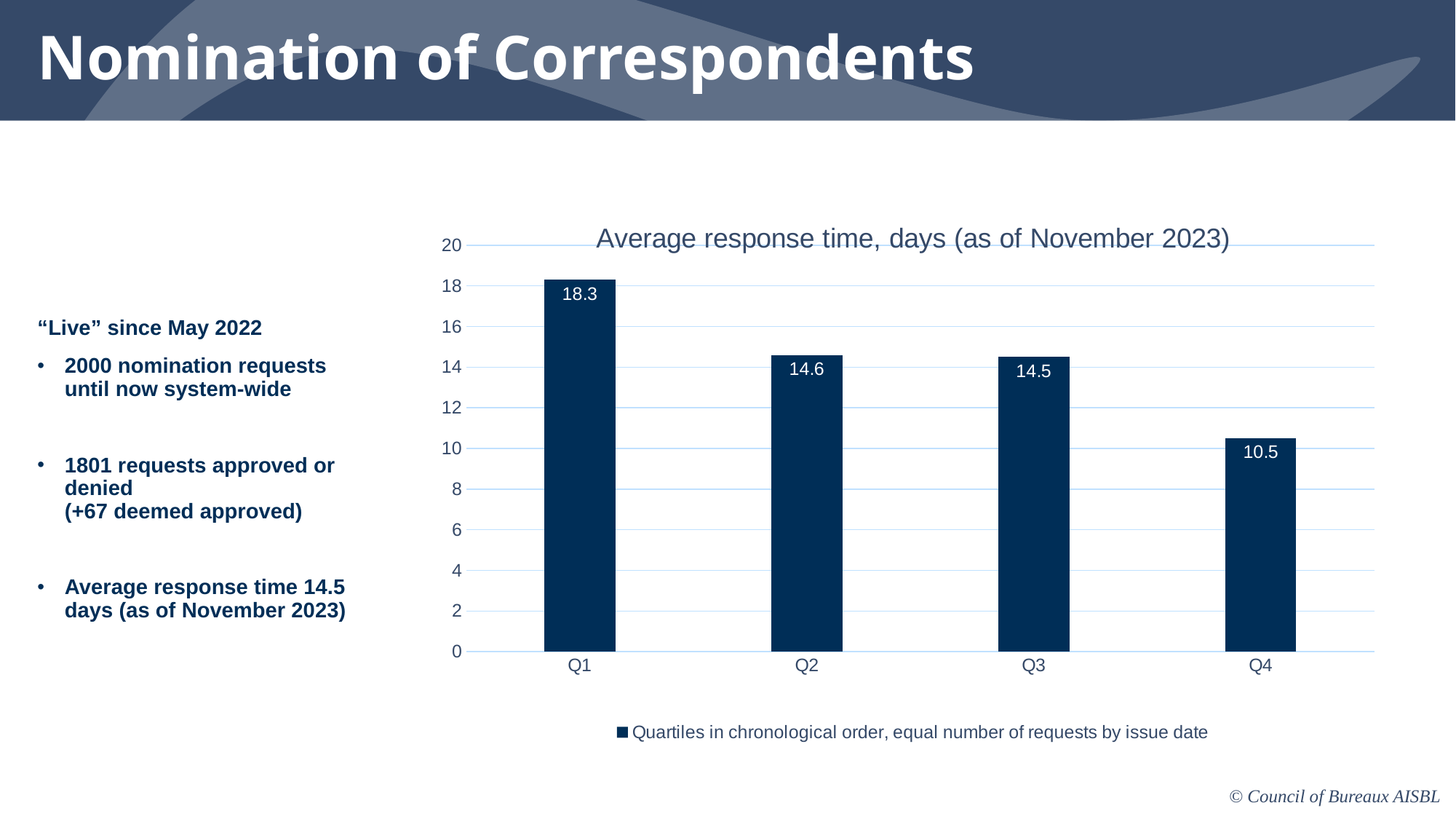
What is the value shown for Q2? 14.6 Which is larger, the value for Q1 or the value for Q3? Q1 Which quartile has the highest average response time? Q1 What kind of chart is shown on the slide? Bar chart Do the values rise or fall from Q1 to Q4? Fall Is the value for Q3 greater or less than 12? greater What is the average response time for Q4? 10.5 What is the average response time for Q1? 18.3 How many quartiles are plotted on the chart? 4 What is the title of the chart? Average response time, days (as of November 2023) Which quartile has the lowest average response time? Q4 What is the difference between the Q1 and Q4 values? 7.8